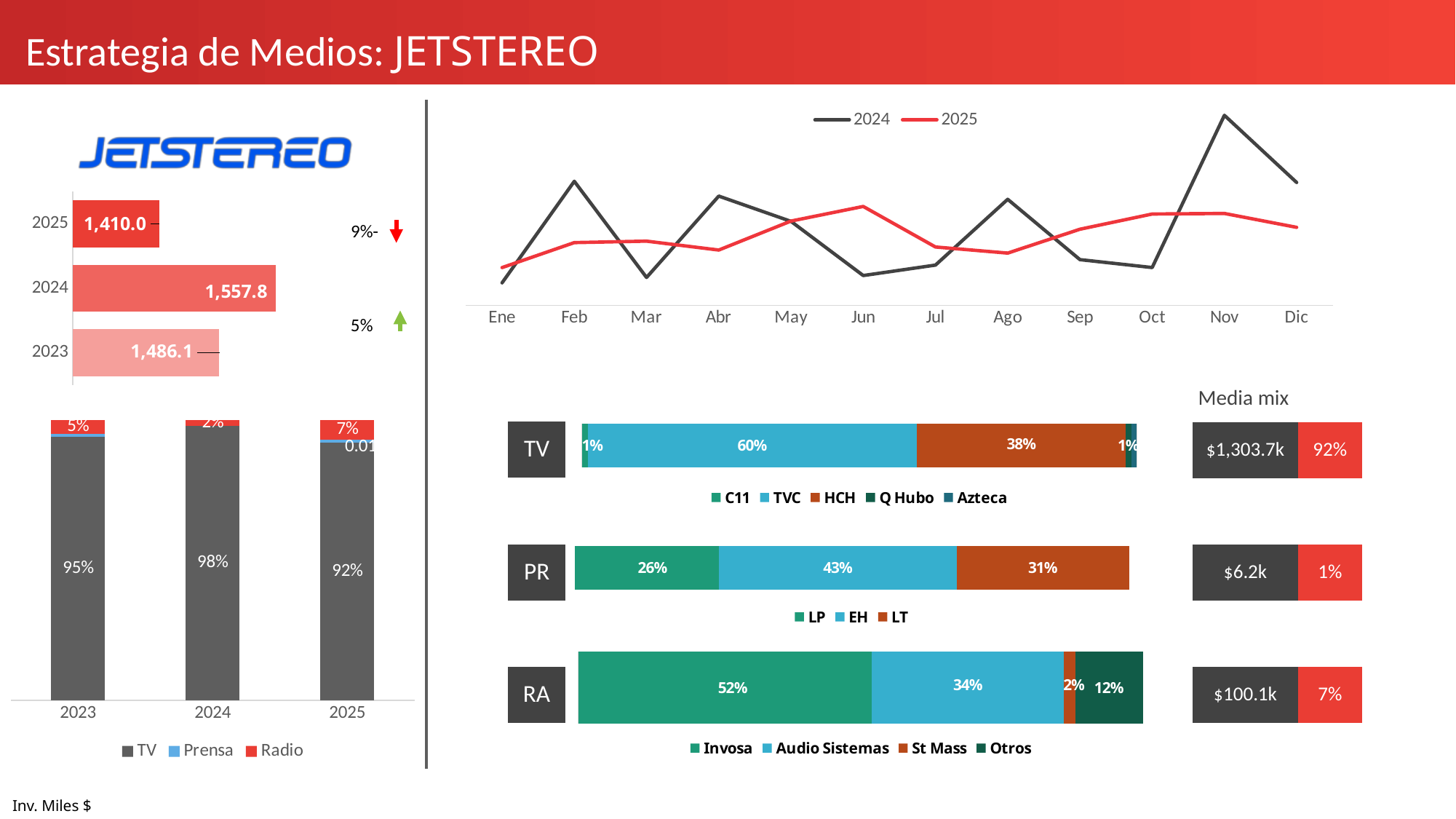
In the horizontal bar chart of yearly investment on the left, which year has the highest value? 2024 In the Media mix section on the right, what is the amount shown for TV? $1,303.7k In the horizontal bar chart of yearly investment on the left, what is the value for 2024? 1,557.8 In the TV stacked bar on the right, what is the share for TVC? 60% In the horizontal bar chart of yearly investment on the left, which year has the lowest value? 2025 In the RA stacked bar on the right, which channel has the largest share? Invosa How many series does the legend of the stacked bar chart at the bottom left list? 3 In the horizontal bar chart of yearly investment on the left, which is larger, the value for 2023 or for 2025? 2023 In the horizontal bar chart of yearly investment on the left, what is the difference between the 2024 and 2023 values? 71.7 What kind of chart is the monthly chart at the top right with the 2024 and 2025 series? Line chart In the monthly line chart at the top right, in which month does the 2024 series reach its highest point? Nov In the stacked bar chart at the bottom left, what is the TV share for 2025? 92%